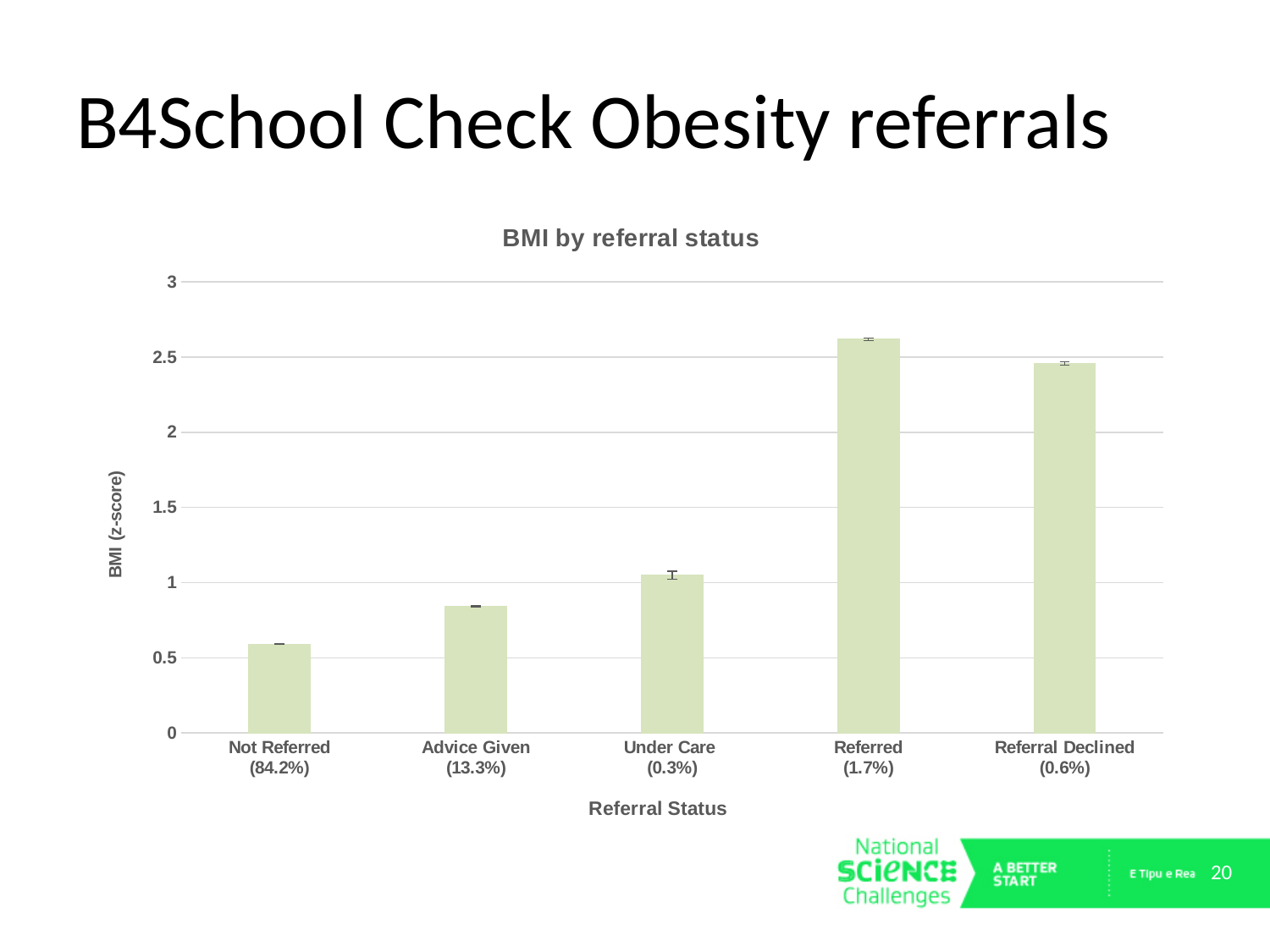
Which is larger, the value for Advice Given or the value for Not Referred? Advice Given Is the value for Advice Given greater or less than 1? less Is the value for Referral Declined greater or less than 2? greater Which is larger, the value for Referred or the value for Referral Declined? Referred What type of chart is shown on the slide? bar chart Which referral status has the lowest BMI z-score? Not Referred How many referral status categories are shown on the x axis? 5 Is the value for Not Referred greater or less than 1? less Which referral status has the highest BMI z-score? Referred What is the label on the y axis? BMI (z-score) What is the title of the chart? BMI by referral status